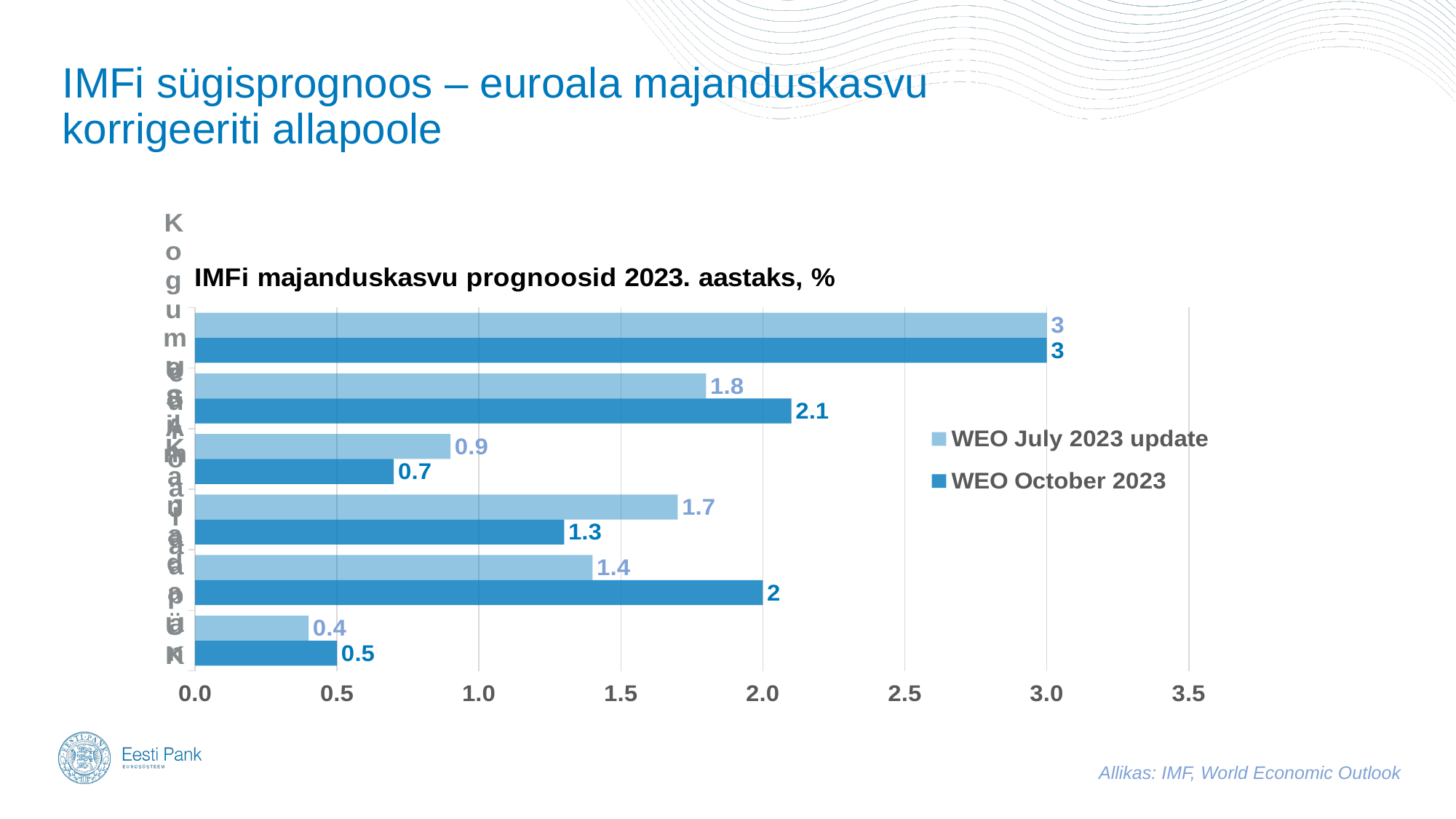
How many groups of bars (categories) are plotted in the chart? 6 In the fifth group of bars from the top, what is the difference between the WEO October 2023 value and the WEO July 2023 update value? 0.6 What is the WEO October 2023 value for the topmost group of bars? 3 What are the two series named in the chart legend? WEO July 2023 update; WEO October 2023 In the bottom group of bars, which series has the larger value, WEO July 2023 update or WEO October 2023? WEO October 2023 How many series does the chart legend list? 2 What is the WEO July 2023 update value for the fourth group of bars from the top? 1.7 What is the title of the chart? IMFi majanduskasvu prognoosid 2023. aastaks, % What is the highest WEO October 2023 value shown in the chart? 3 In the second group of bars from the top, how much higher is the WEO October 2023 value than the WEO July 2023 update value? 0.3 What kind of chart is shown on the slide? bar chart What is the lowest WEO July 2023 update value shown in the chart? 0.4